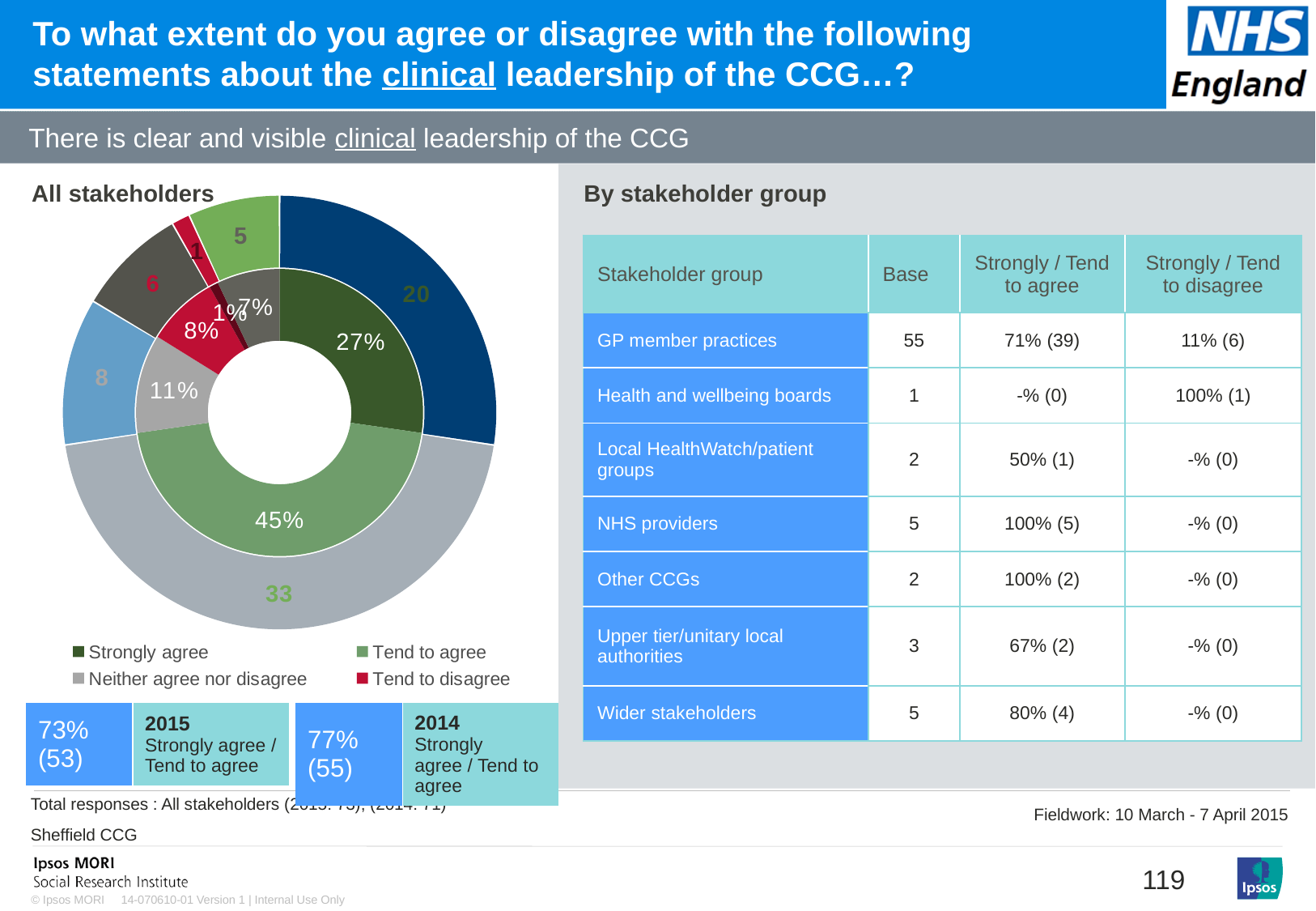
What colour represents 'Tend to disagree' in the 'All stakeholders' chart? red In the 'All stakeholders' chart, what percentage of respondents 'Neither agree nor disagree'? 11% In the 'All stakeholders' chart, how many respondents (outer ring count) 'Strongly agree'? 20 In the 'All stakeholders' chart, which is larger: the share for 'Neither agree nor disagree' or the share for 'Tend to disagree'? Neither agree nor disagree What type of chart is shown under 'All stakeholders'? doughnut chart In the 'All stakeholders' chart, how many respondents (outer ring count) 'Tend to agree'? 33 How many entries does the legend of the 'All stakeholders' chart list? 4 In the 'All stakeholders' chart, what percentage of respondents 'Tend to agree'? 45% In the 'All stakeholders' chart, what percentage of respondents 'Tend to disagree'? 8% In the 'All stakeholders' chart, what percentage of respondents 'Strongly agree'? 27% In the 'All stakeholders' chart, which response category has the largest share? Tend to agree In the 'All stakeholders' chart, what is the difference in percentage points between 'Tend to agree' and 'Strongly agree'? 18